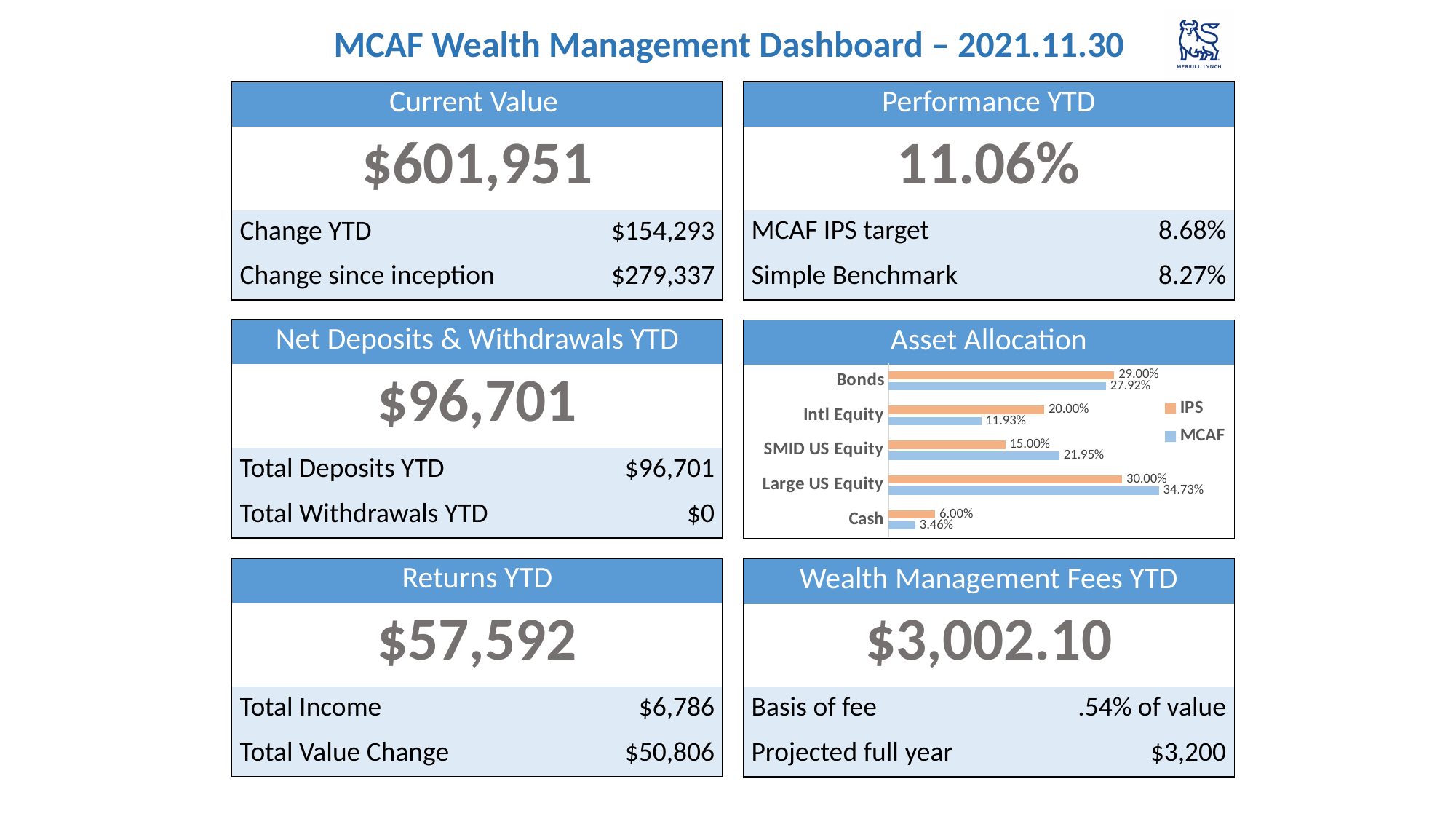
How many categories are shown in the Asset Allocation chart? 5 How many series does the legend of the Asset Allocation chart list? 2 In the Asset Allocation chart, what is the MCAF value for Large US Equity? 34.73% In the Asset Allocation chart, what is the difference between the IPS and MCAF values for SMID US Equity? 6.95% In the Asset Allocation chart, which is larger for Intl Equity, the IPS value or the MCAF value? IPS What kind of chart is the Asset Allocation chart? Bar chart In the Asset Allocation chart, which category has the lowest IPS value? Cash In the Asset Allocation chart, what is the MCAF value for Intl Equity? 11.93% In the Asset Allocation chart, what is the IPS value for Cash? 6.00% In the Asset Allocation chart, what is the IPS value for Bonds? 29.00% In the Asset Allocation chart, which category has the highest MCAF value? Large US Equity In the Asset Allocation chart, which series is shown in orange? IPS